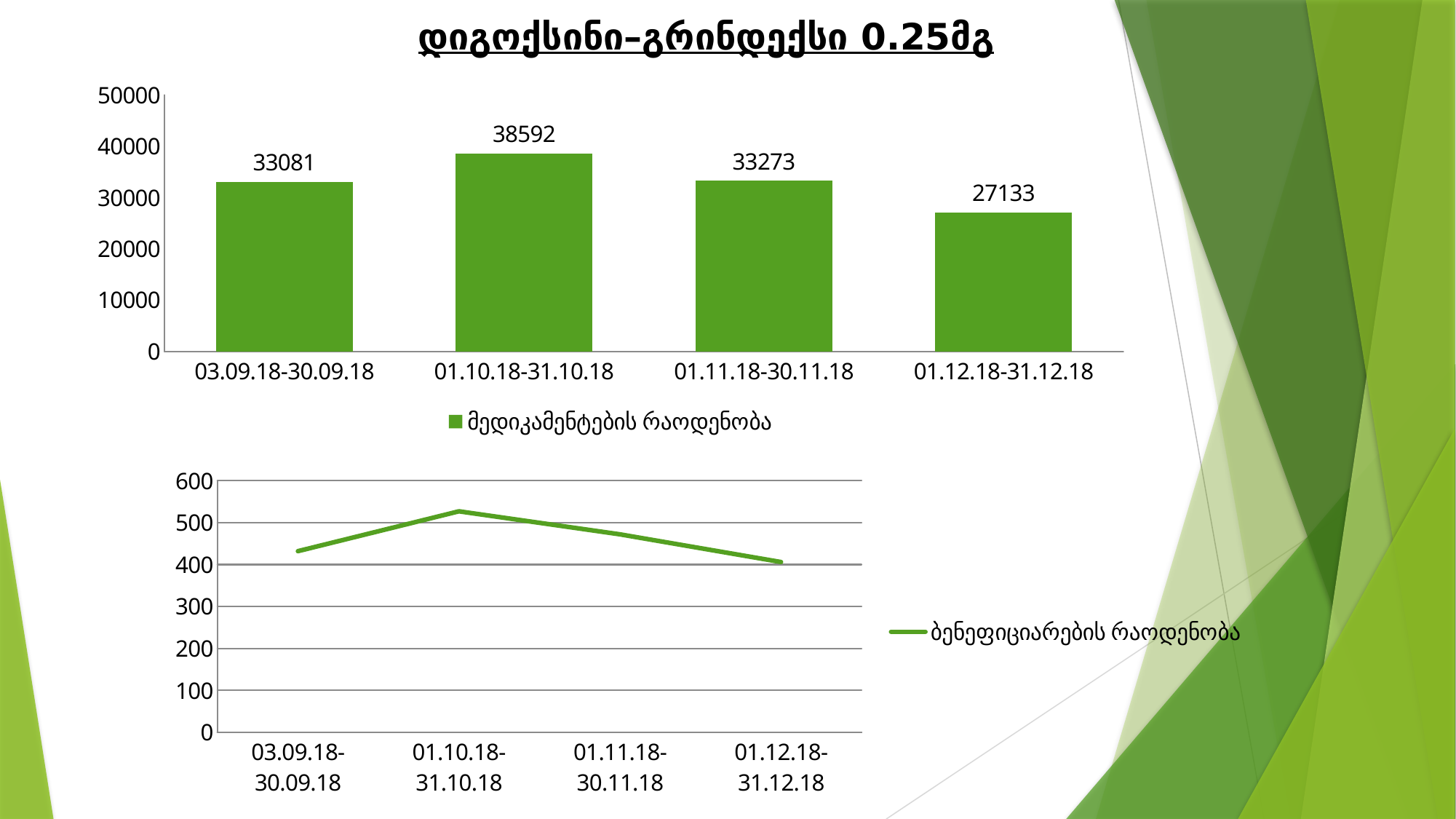
In the bottom line chart, which period has the highest value? 01.10.18-31.10.18 What type of chart is the top chart on the slide? Bar chart In the top bar chart, which period has the lowest value? 01.12.18-31.12.18 In the top bar chart, what is the difference between the values for 01.10.18-31.10.18 and 01.12.18-31.12.18? 11459 In the bottom line chart, is the value for 03.09.18-30.09.18 greater or less than 500? less How many bars are in the top bar chart? 4 In the top bar chart, what is the value for 01.12.18-31.12.18? 27133 What type of chart is the bottom chart on the slide? Line chart In the top bar chart, which is larger: the value for 03.09.18-30.09.18 or the value for 01.11.18-30.11.18? 01.11.18-30.11.18 In the top bar chart, which period has the highest value? 01.10.18-31.10.18 In the top bar chart, what is the value for 03.09.18-30.09.18? 33081 In the bottom line chart, is the value for 01.10.18-31.10.18 greater or less than 500? greater